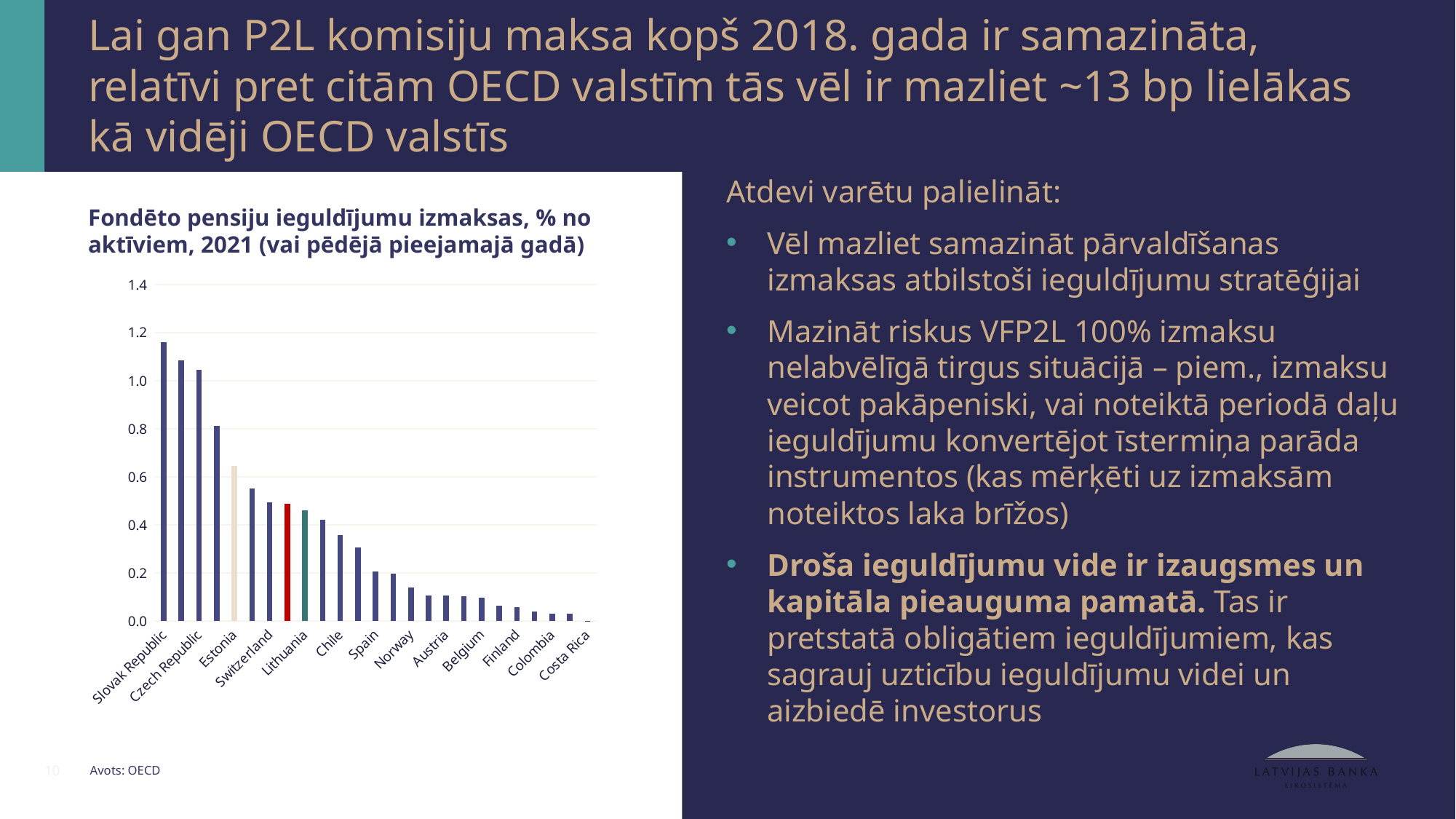
Is the value for Estonia greater or less than 0.6? greater Is the value for Slovak Republic greater or less than 1.0? greater Which has a higher value, Estonia or Lithuania? Estonia Is the value for Norway greater or less than 0.2? less Do the values rise or fall moving from left to right along the x axis? Fall Which has a higher value, Switzerland or Chile? Switzerland Which labelled country has the lowest value in the chart? Costa Rica What kind of chart is shown on the slide? Bar chart What source is cited for the chart? OECD Which country has the highest pension investment cost in the chart? Slovak Republic